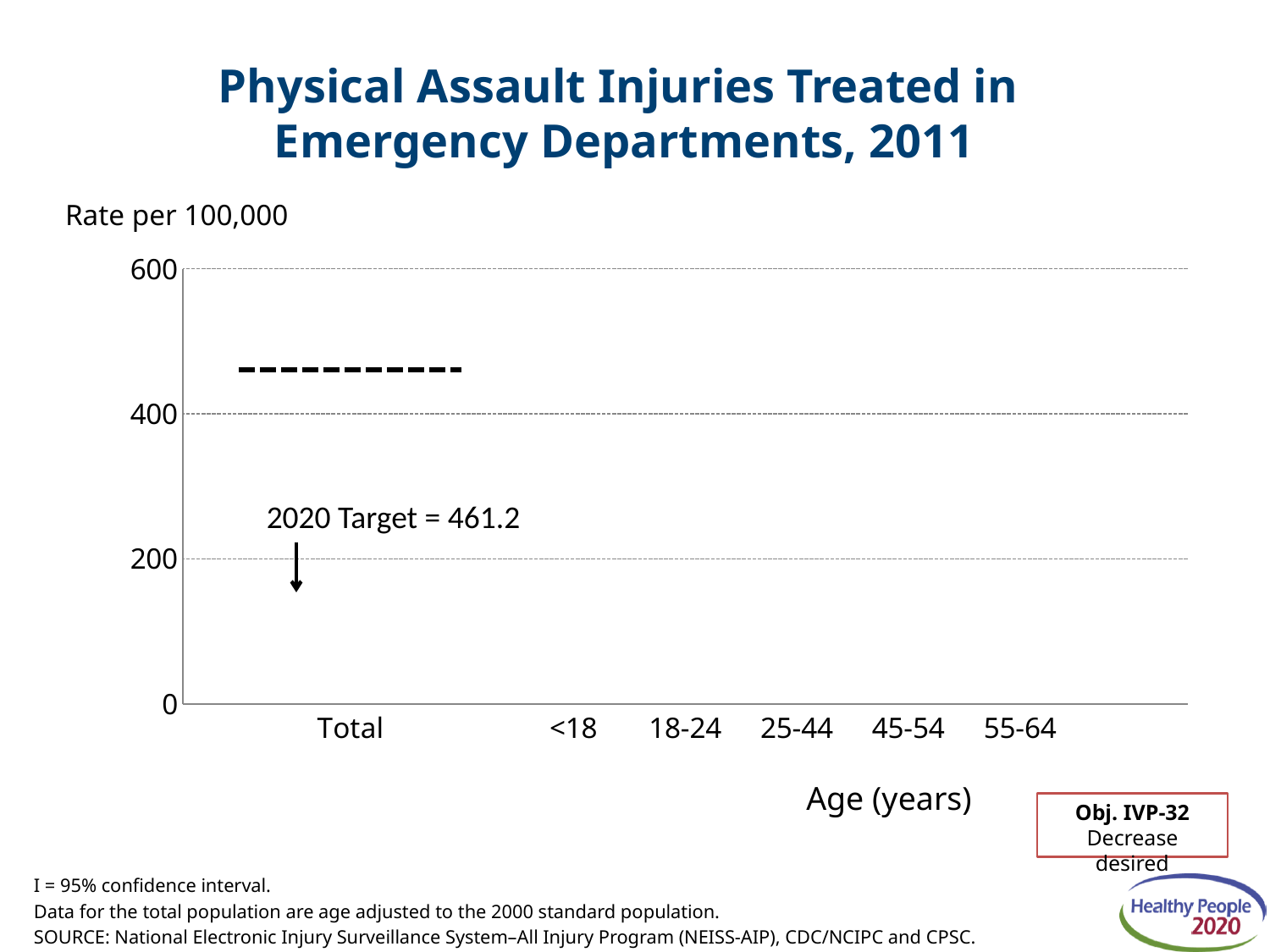
What is the label of the x axis of the chart? Age (years) How many age categories are labeled on the x axis of the chart? 6 What is the label of the y axis of the chart? Rate per 100,000 What is the 2020 Target value shown on the chart? 461.2 Is the 2020 Target line on the chart greater or less than 400? greater What is the first category listed on the x axis of the chart? Total Is the 2020 Target line on the chart greater or less than 600? less What is the last age group listed on the x axis of the chart? 55-64 What is the highest value shown on the y axis of the chart? 600